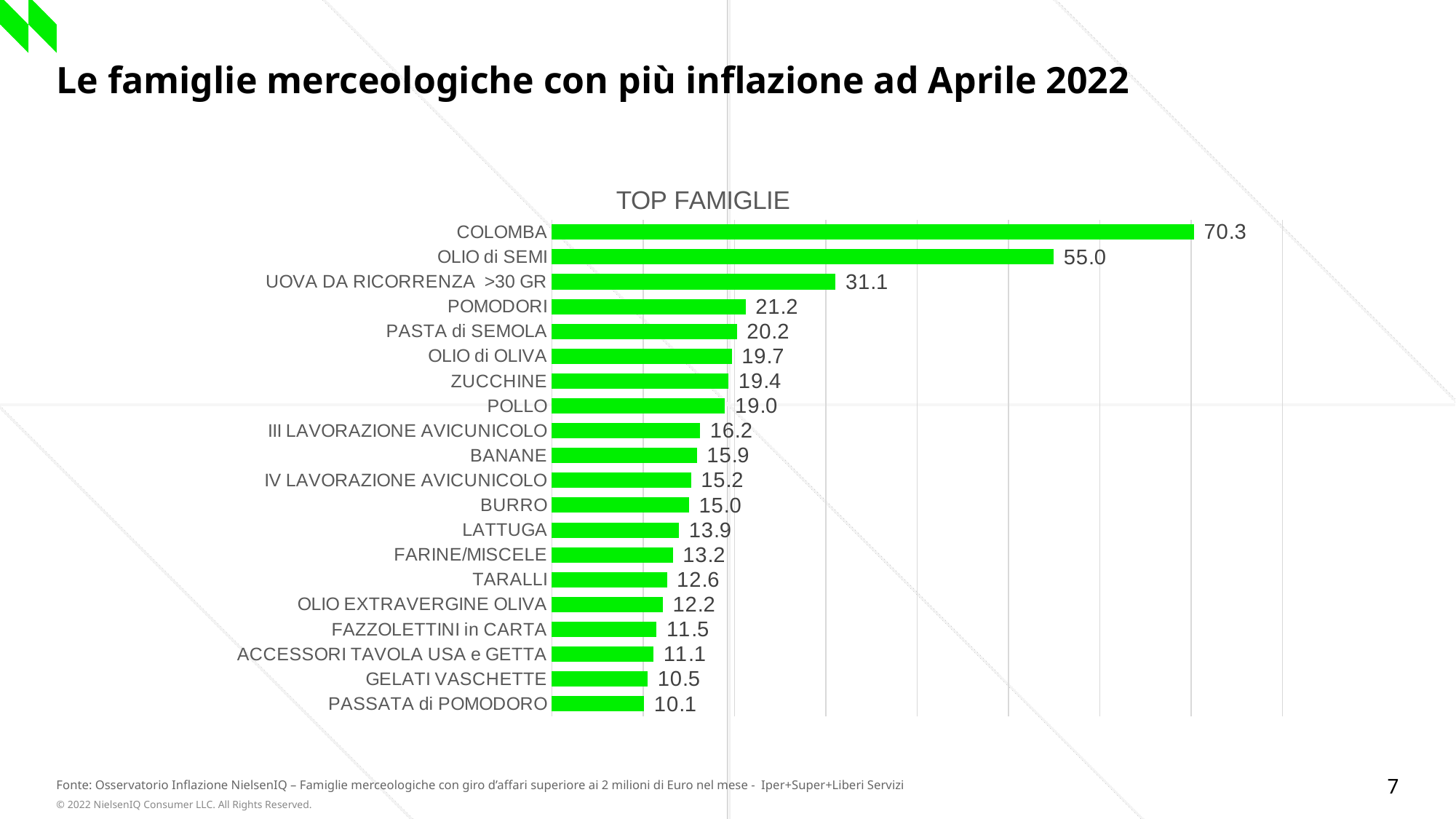
What kind of chart is shown on the slide? Bar chart How many categories are shown in the chart? 20 What is the title of the chart? TOP FAMIGLIE What is the difference between the values for POMODORI and BURRO? 6.2 What is the value for GELATI VASCHETTE? 10.5 Which has a larger value, UOVA DA RICORRENZA >30 GR or POMODORI? UOVA DA RICORRENZA >30 GR What is the value for PASTA di SEMOLA? 20.2 What is the difference between the values for COLOMBA and OLIO di SEMI? 15.3 Which category has the highest value in the chart? COLOMBA Which category has the lowest value in the chart? PASSATA di POMODORO What is the value for COLOMBA in the TOP FAMIGLIE chart? 70.3 Which has a larger value, TARALLI or FAZZOLETTINI in CARTA? TARALLI